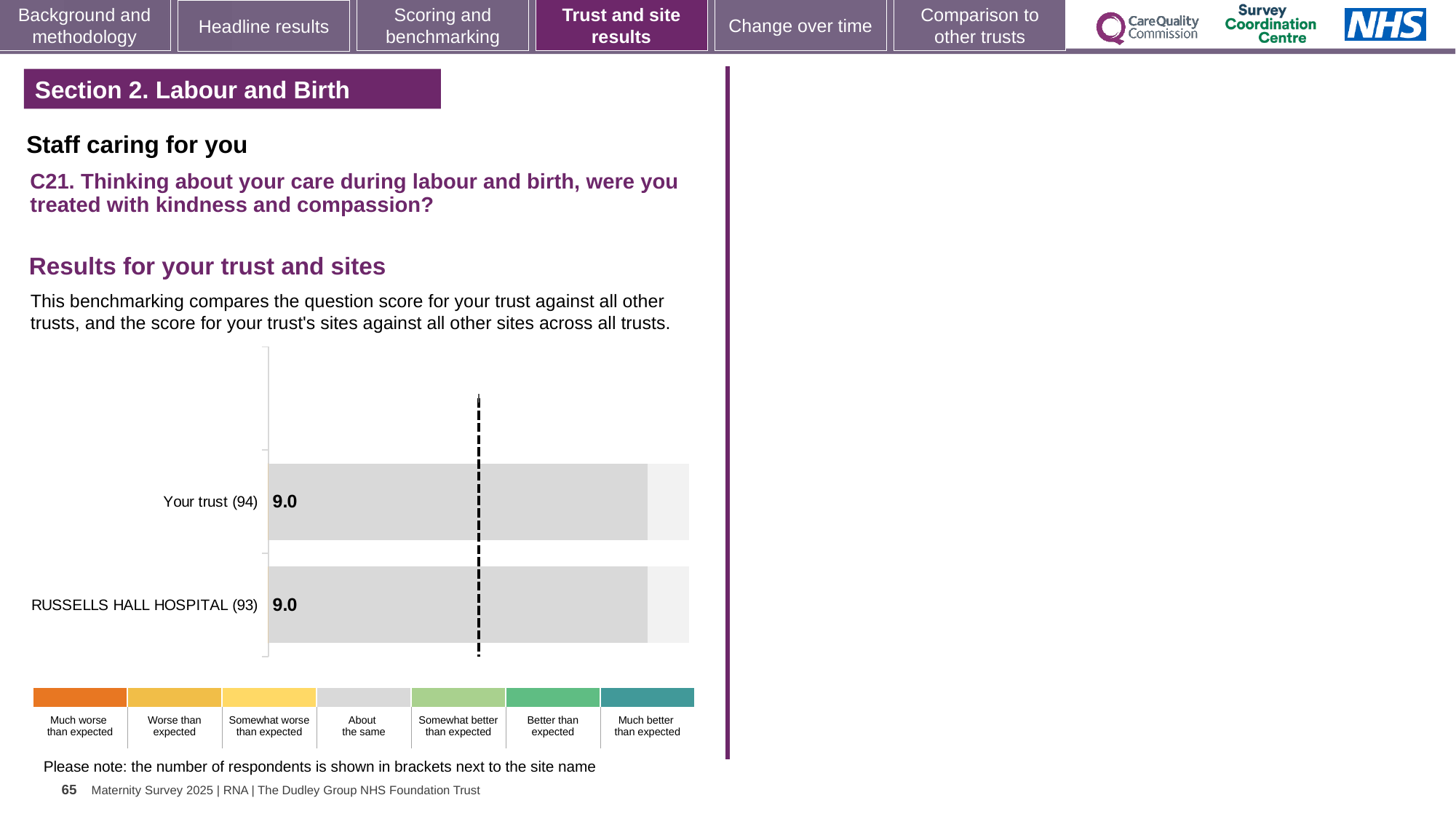
How many respondents are shown in brackets for Your trust? 94 How many bars are plotted on the chart? 2 How many respondents are shown in brackets for RUSSELLS HALL HOSPITAL? 93 What is the score for Your trust (94) on the chart? 9.0 Which survey question does the chart relate to? C21. Thinking about your care during labour and birth, were you treated with kindness and compassion? What is the score for RUSSELLS HALL HOSPITAL (93) on the chart? 9.0 Which benchmark category does the grey colour of the bars correspond to in the key? About the same What kind of chart is shown on the slide? bar chart How many benchmark categories does the colour key below the chart list? 7 What is the difference between the score for Your trust (94) and the score for RUSSELLS HALL HOSPITAL (93)? 0.0